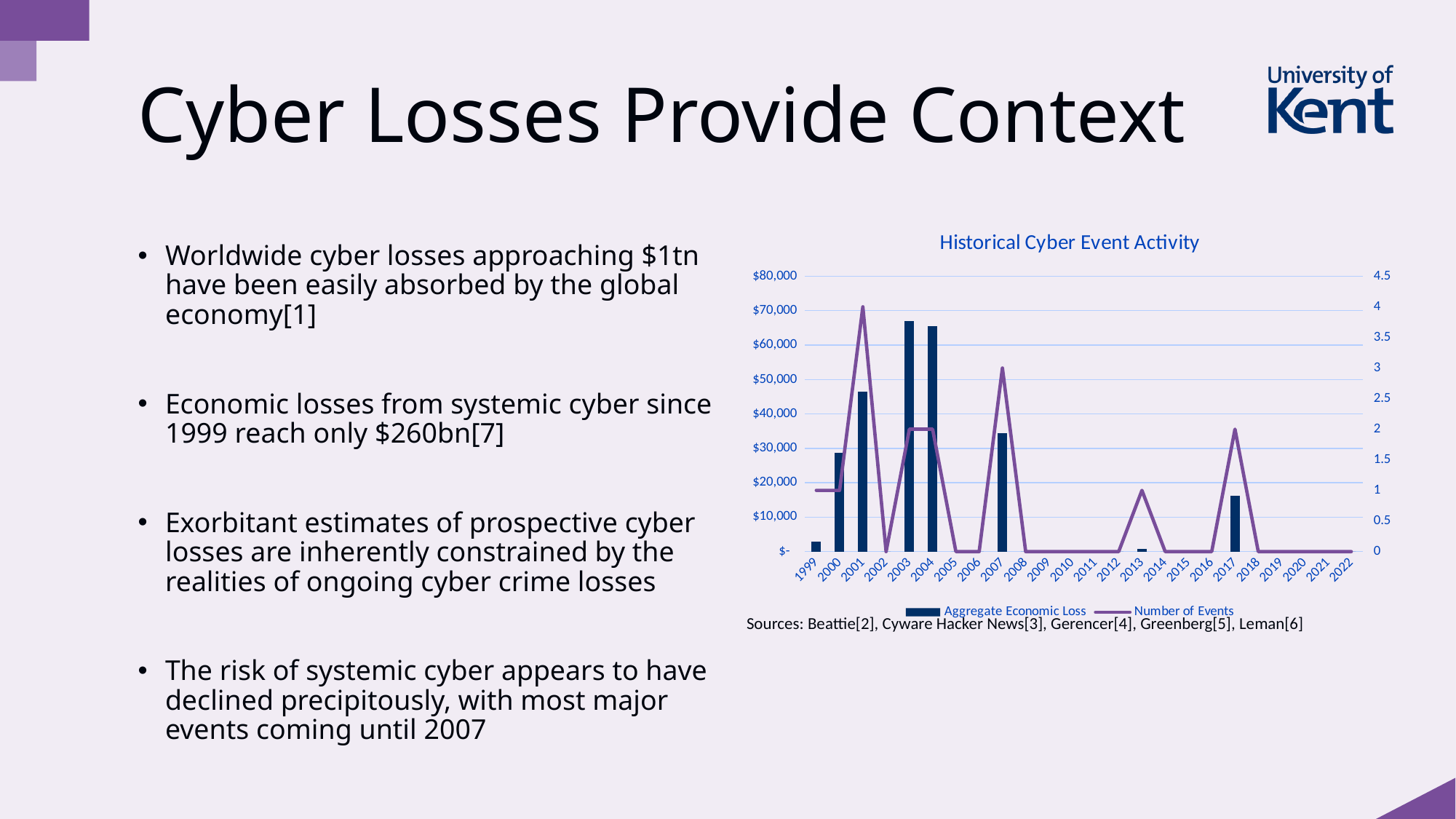
What is the Number of Events in 2007? 3 Is the Aggregate Economic Loss for 2001 greater or less than $40,000? greater How many years are shown along the x axis of the chart? 24 What is the Number of Events in 2001? 4 Which series is drawn as a line in the chart? Number of Events What is the Number of Events in 2013? 1 What is the title of the chart on the slide? Historical Cyber Event Activity In which year is the Number of Events highest? 2001 Which year has the larger Aggregate Economic Loss, 2001 or 2007? 2001 What kind of chart is shown on the slide? A combined bar and line chart How many series does the chart's legend list? 2 Is the Aggregate Economic Loss for 2017 greater or less than $20,000? less